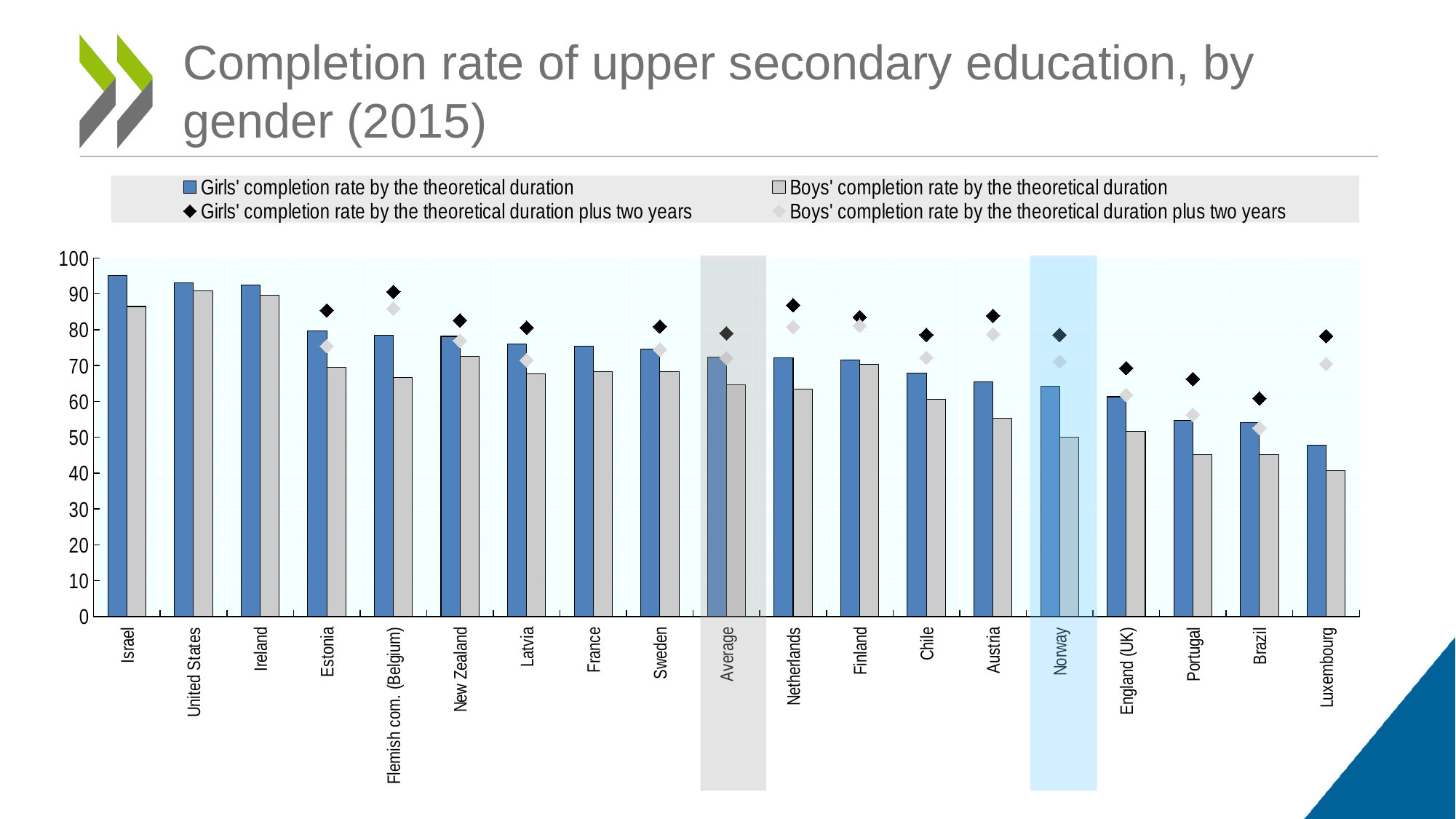
Which category has the lowest girls' completion rate by the theoretical duration? Luxembourg How many series does the legend list? 4 What is the title of the chart on the slide? Completion rate of upper secondary education, by gender (2015) Is the boys' completion rate by the theoretical duration for Portugal greater or less than 50? less Which category has the lowest boys' completion rate by the theoretical duration? Luxembourg What kind of chart is shown on the slide? bar chart Is the girls' completion rate by the theoretical duration for Israel greater or less than 90? greater How many countries/categories are shown along the x axis? 19 Is the boys' completion rate by the theoretical duration for Netherlands greater or less than 60? greater In Norway, which is larger: the girls' or the boys' completion rate by the theoretical duration? girls' Which category has the highest girls' completion rate by the theoretical duration? Israel Do the girls' completion rates by the theoretical duration rise or fall from left to right along the x axis? fall